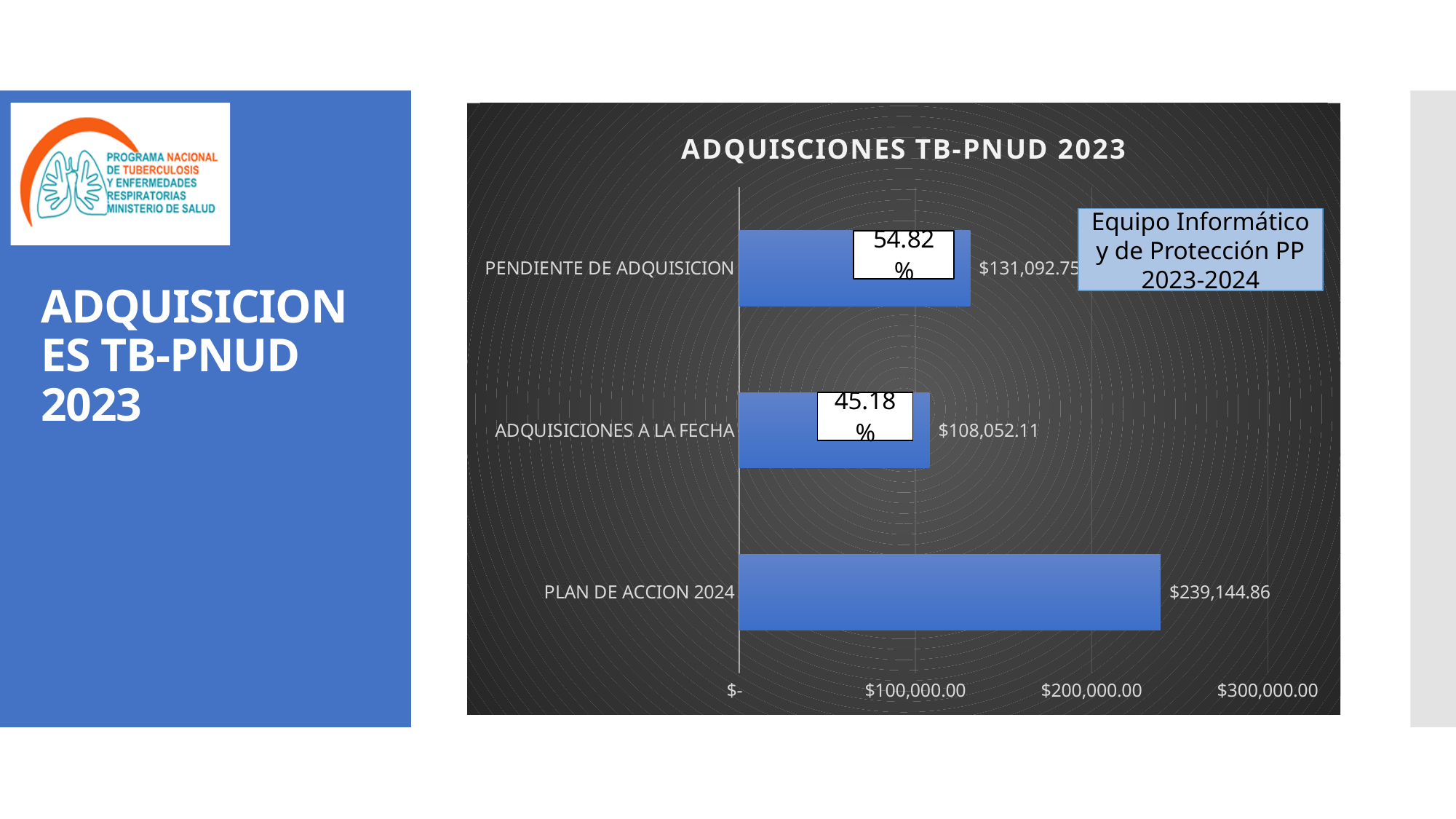
What is the value for ADQUISICIONES A LA FECHA? $108,052.11 What is the difference between PLAN DE ACCION 2024 and ADQUISICIONES A LA FECHA? $131,092.75 Is the value for PLAN DE ACCION 2024 greater or less than $200,000.00? greater How many categories are shown in the chart? 3 What is the difference between PENDIENTE DE ADQUISICION and ADQUISICIONES A LA FECHA? $23,040.64 What is the value for PLAN DE ACCION 2024? $239,144.86 Which category has the lowest value? ADQUISICIONES A LA FECHA Which category has the highest value? PLAN DE ACCION 2024 What is the value for PENDIENTE DE ADQUISICION? $131,092.75 What kind of chart is shown on the slide? bar chart What percentage label is shown on the PENDIENTE DE ADQUISICION bar? 54.82% Which is larger, PENDIENTE DE ADQUISICION or ADQUISICIONES A LA FECHA? PENDIENTE DE ADQUISICION